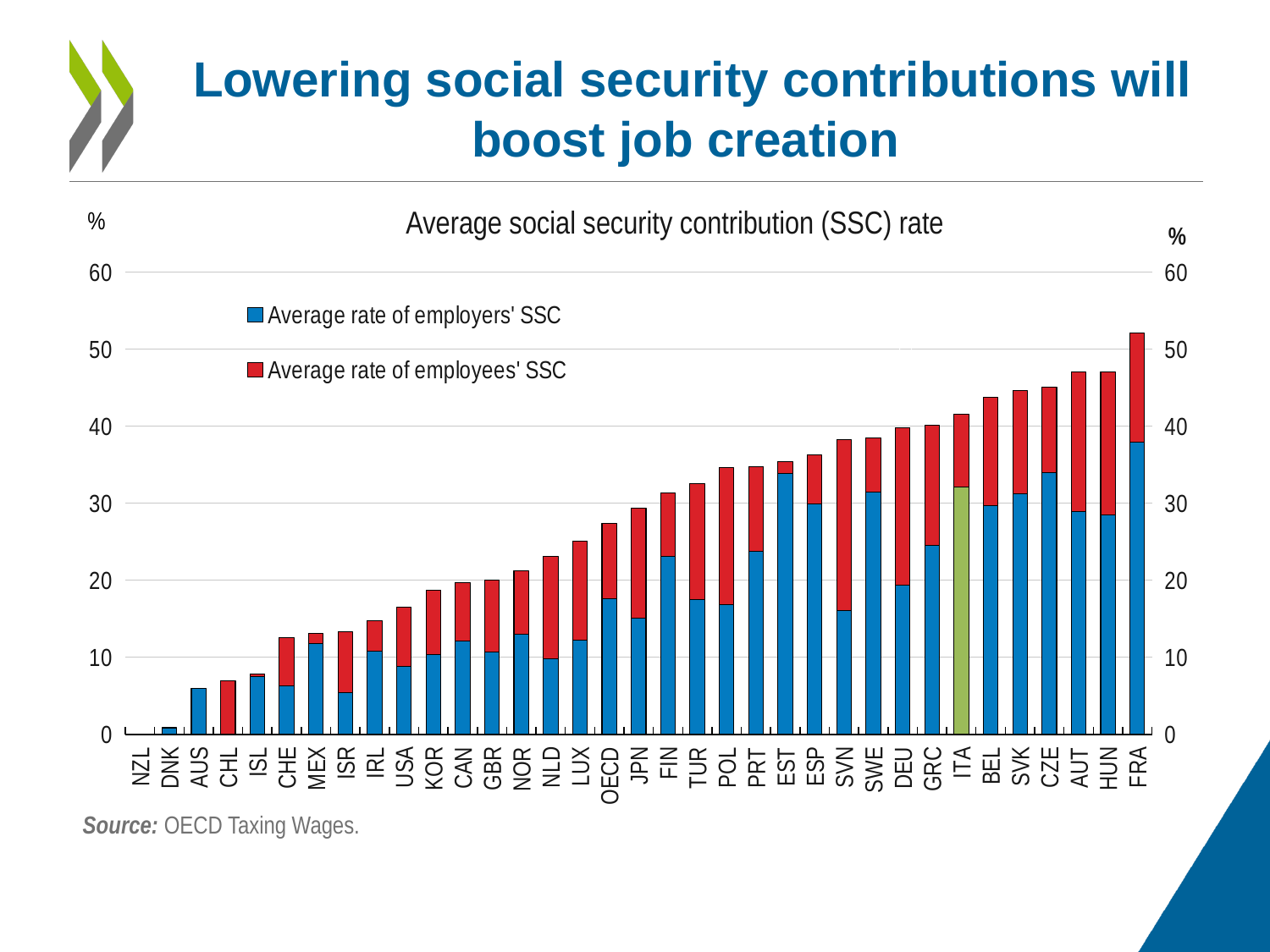
Is the total average SSC rate for FRA greater or less than 50? greater How many countries/categories are shown along the x axis? 35 Is the average rate of employers' SSC for EST greater or less than 30? greater What kind of chart is shown on the slide? Stacked bar chart Which category has the highest total average SSC rate? FRA Which country's bar is highlighted in green? ITA Is the total average SSC rate for OECD greater or less than 30? less Do the total SSC rates rise or fall moving from left to right along the x axis? Rise Which category has the lowest total average SSC rate? NZL Which has the larger average rate of employers' SSC, EST or ESP? EST How many series does the legend list? 2